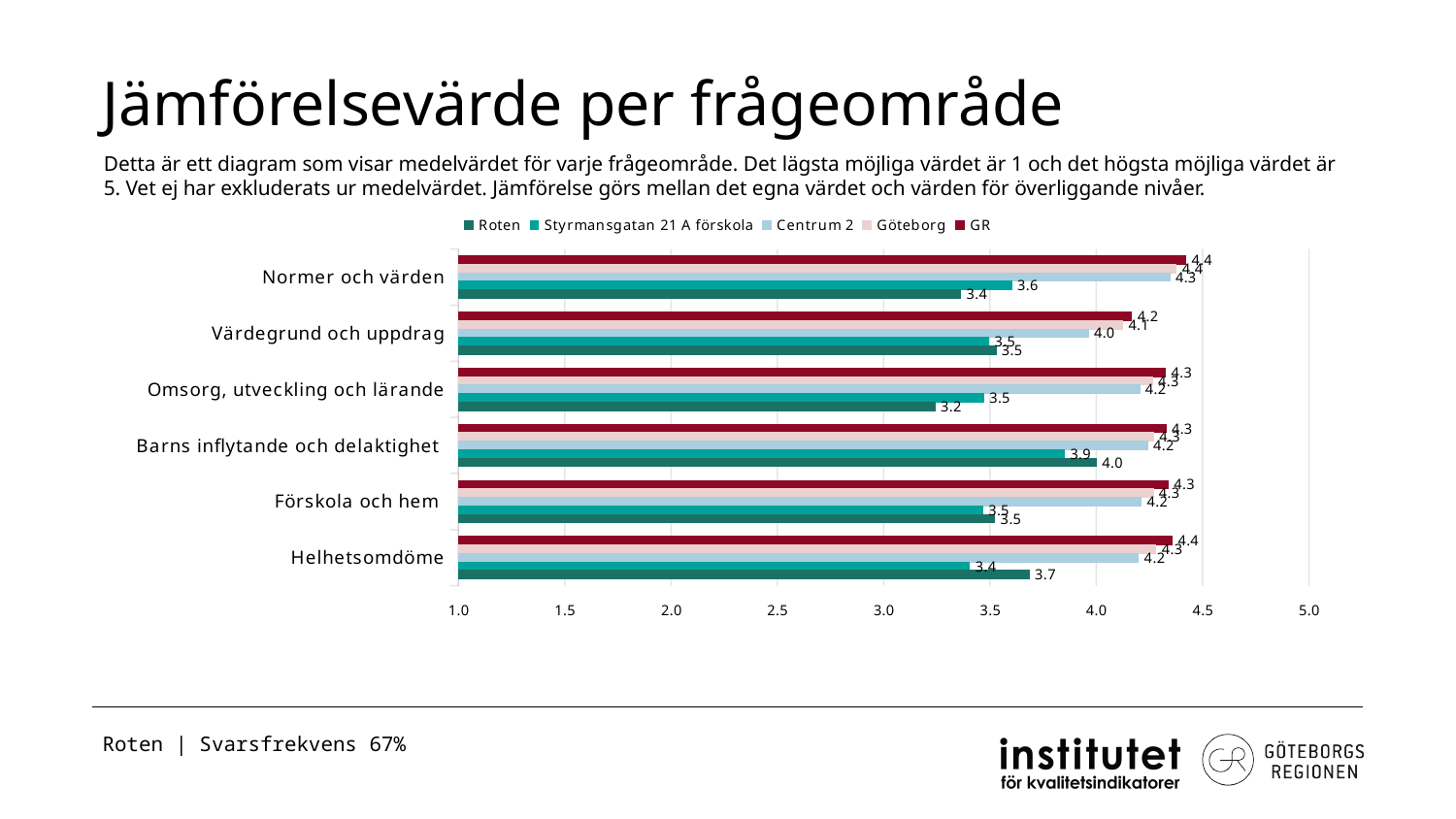
What kind of chart is shown on the slide? bar chart What is the value for Centrum 2 in the category Värdegrund och uppdrag? 4.0 How many question areas (categories) are shown on the chart? 6 What is the difference between the Styrmansgatan 21 A förskola value and the Roten value for Normer och värden? 0.2 How many series does the legend list? 5 Is the value for GR in the category Normer och värden greater or less than 4.0? greater What is the value for Styrmansgatan 21 A förskola in the category Normer och värden? 3.6 What is the value for Roten in the category Omsorg, utveckling och lärande? 3.2 For Helhetsomdöme, which is larger: the value for Roten or the value for Styrmansgatan 21 A förskola? Roten In which category does Roten have its highest value? Barns inflytande och delaktighet What is the value for Roten in the category Helhetsomdöme? 3.7 In which category does Roten have its lowest value? Omsorg, utveckling och lärande